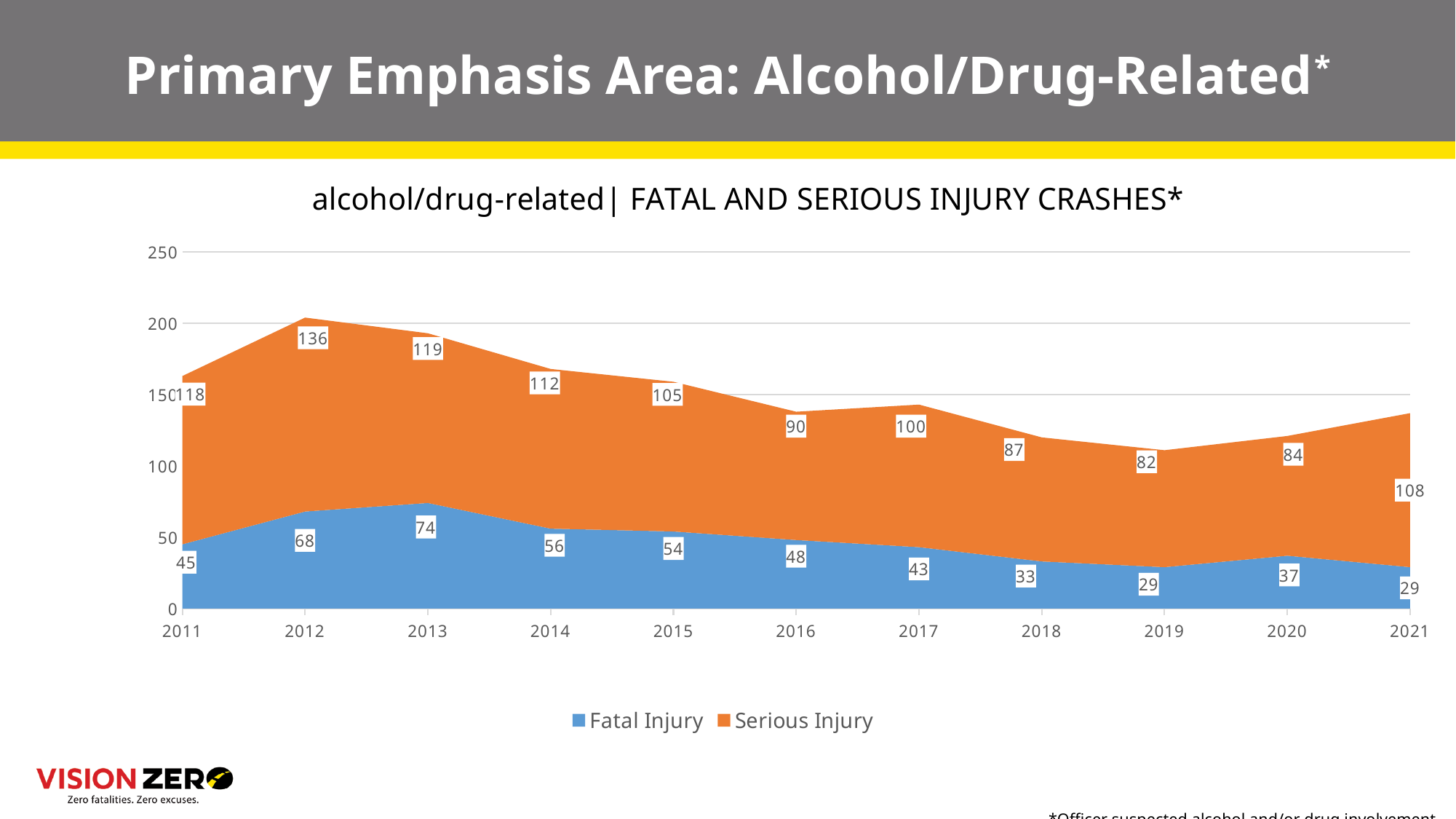
Which year has the lowest Serious Injury value? 2019 How many years are shown on the x axis? 11 What is the Serious Injury value for 2012? 136 Which is larger, the Fatal Injury value for 2020 or for 2021? 2020 What is the difference between the Serious Injury values for 2012 and 2019? 54 What is the Fatal Injury value for 2013? 74 What is the Serious Injury value for 2021? 108 Which year has the highest Fatal Injury value? 2013 What is the total of Fatal Injury and Serious Injury for 2011? 163 Which colour represents Serious Injury in the chart? Orange What kind of chart is shown? Stacked area chart How many series does the legend list? 2